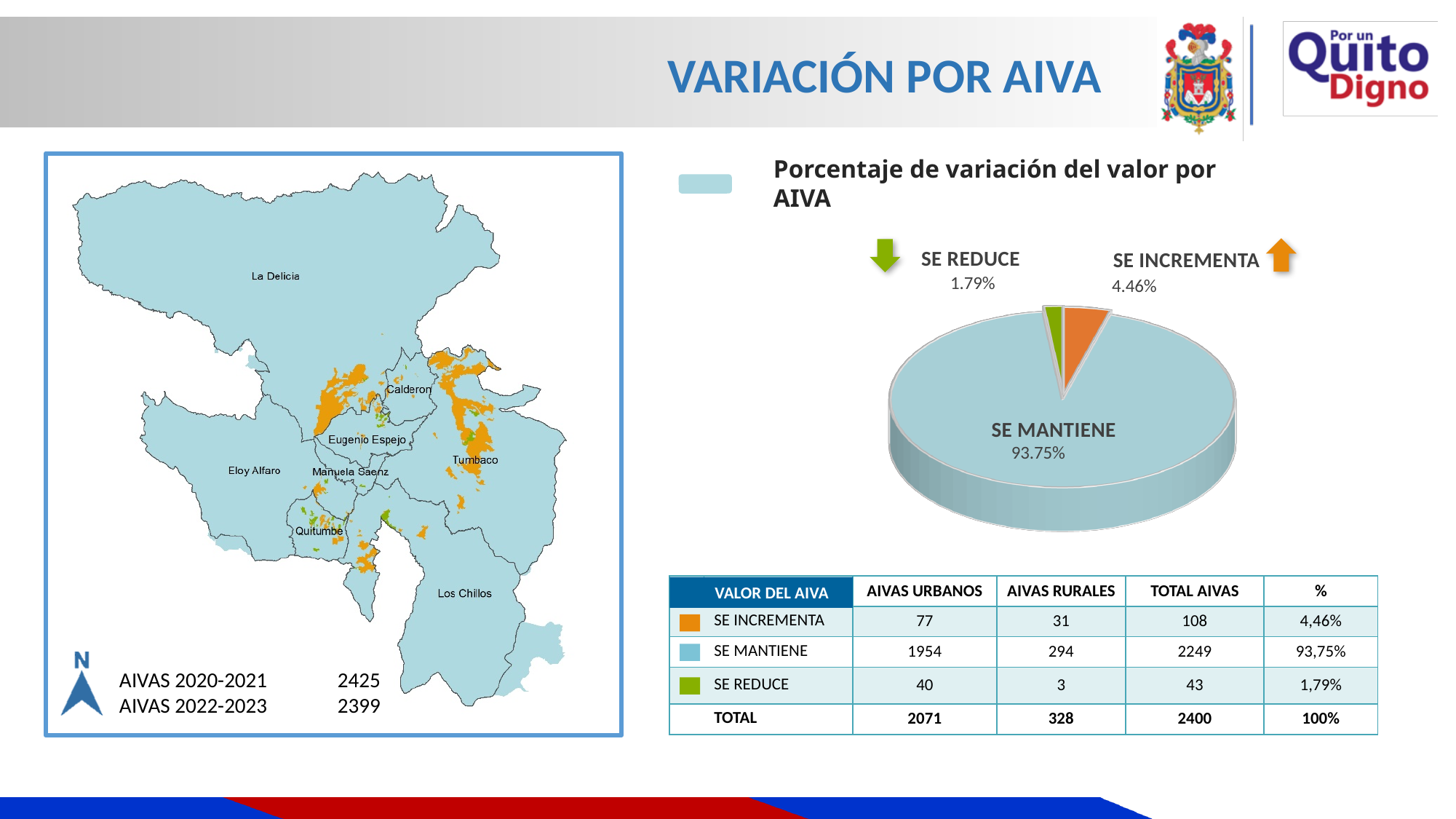
What percentage does the pie chart show for SE INCREMENTA? 4.46% In the pie chart, what is the difference in percentage points between SE MANTIENE and SE INCREMENTA? 89.29 What colour is the SE INCREMENTA slice in the pie chart? orange In the pie chart, what is the difference in percentage points between SE INCREMENTA and SE REDUCE? 2.67 What percentage does the pie chart show for SE REDUCE? 1.79% What is the title of the pie chart? Porcentaje de variación del valor por AIVA Which category has the smallest slice in the pie chart? SE REDUCE How many slices does the pie chart have? 3 Which category has the largest slice in the pie chart? SE MANTIENE In the pie chart, which is larger: SE INCREMENTA or SE REDUCE? SE INCREMENTA What percentage does the pie chart show for SE MANTIENE? 93.75% What kind of chart is shown under the title 'Porcentaje de variación del valor por AIVA'? pie chart